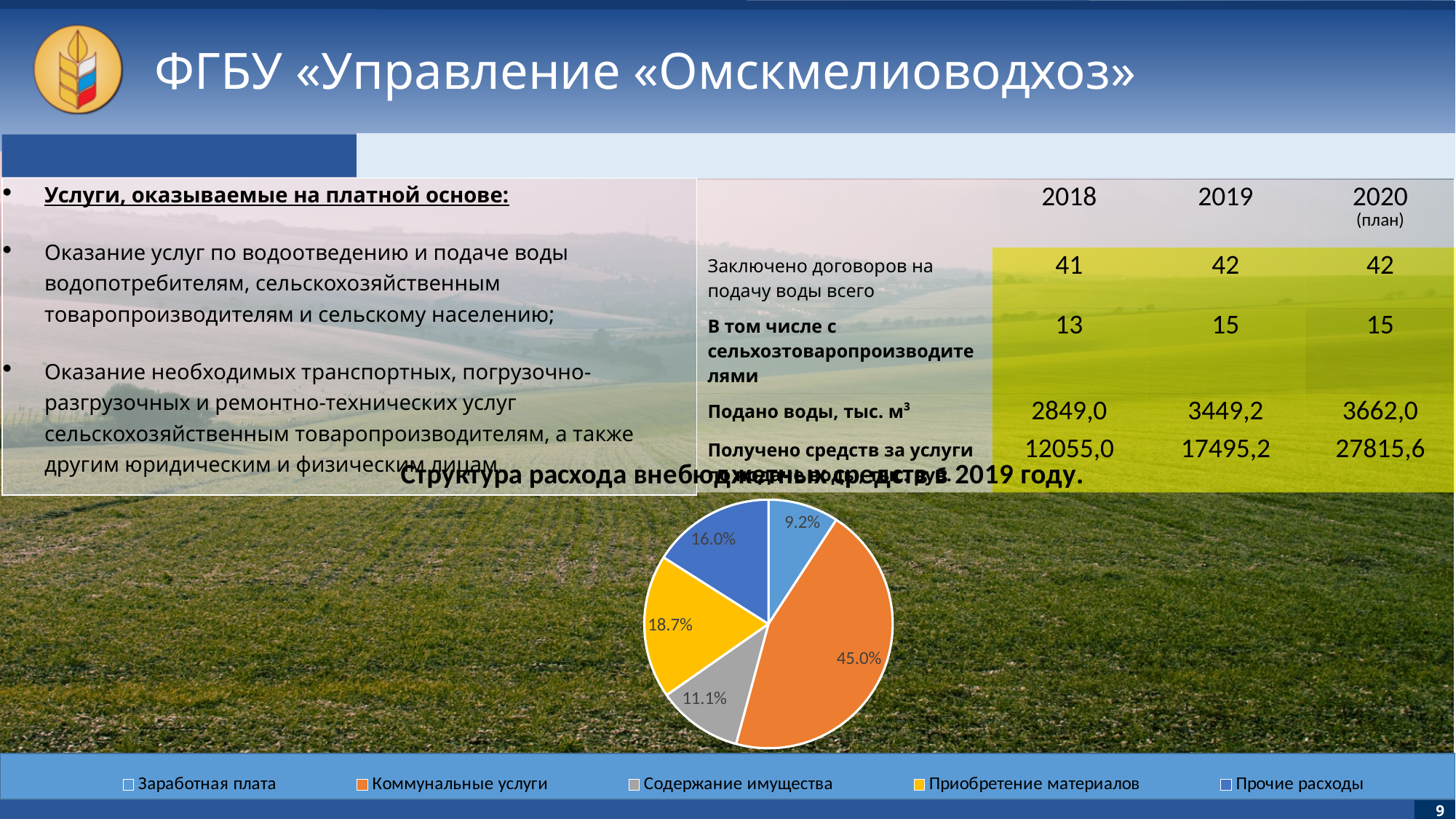
What share of the pie chart is Прочие расходы? 16.0% What share of the pie chart is Коммунальные услуги? 45.0% What share of the pie chart is Заработная плата? 9.2% What share of the pie chart is Приобретение материалов? 18.7% What kind of chart is shown on the slide? pie chart Which is larger in the pie chart, Прочие расходы or Содержание имущества? Прочие расходы Which category has the smallest slice in the pie chart? Заработная плата How many categories does the pie chart legend list? 5 What is the difference in percentage points between Коммунальные услуги and Приобретение материалов in the pie chart? 26.3 Which category has the largest slice in the pie chart? Коммунальные услуги Which colour represents Приобретение материалов in the pie chart? yellow What share of the pie chart is Содержание имущества? 11.1%